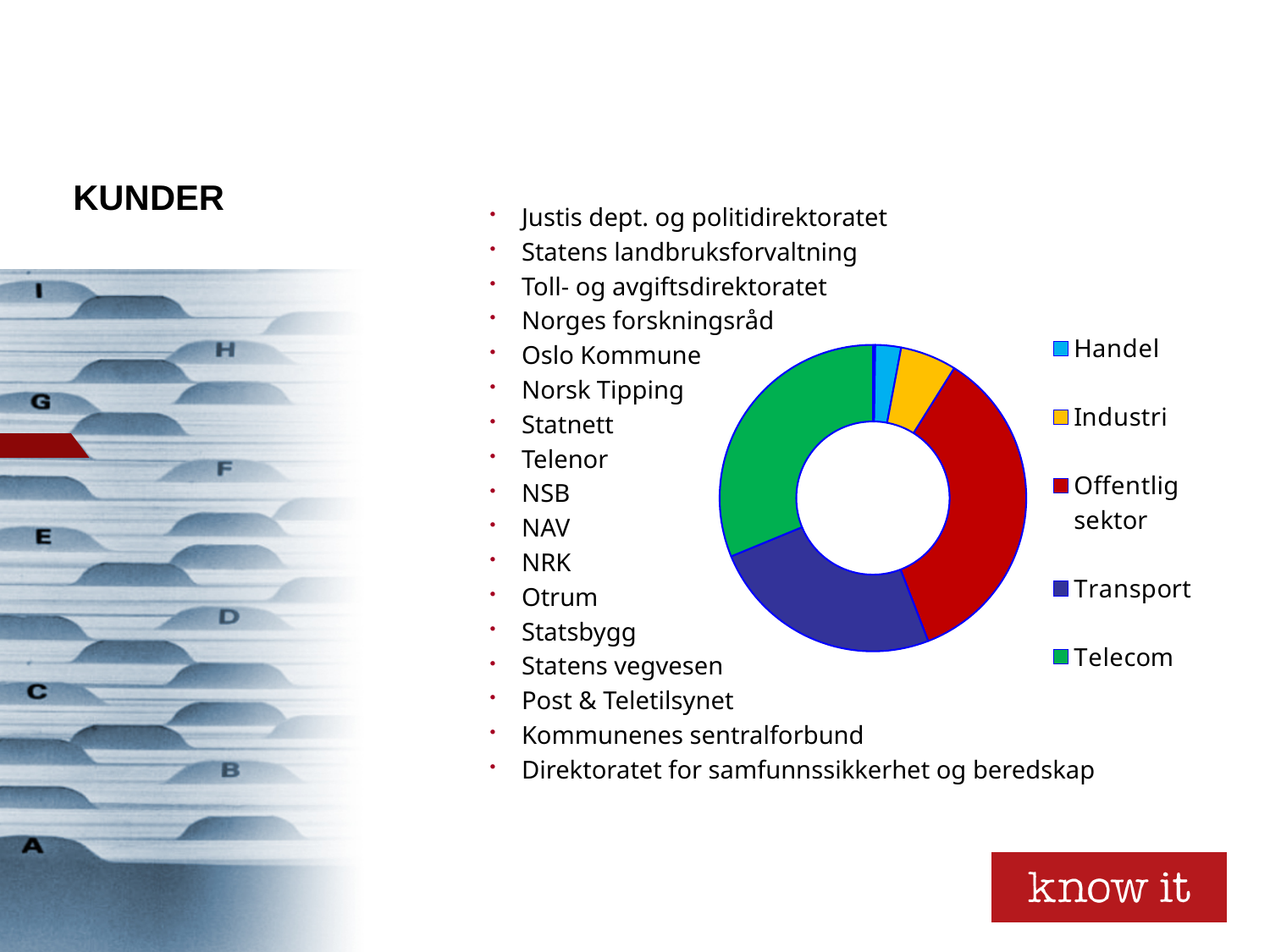
Which slice is larger in the doughnut chart, Handel or Industri? Industri Which slice is larger in the doughnut chart, Telecom or Industri? Telecom Which slice is larger in the doughnut chart, Offentlig sektor or Industri? Offentlig sektor Which colour represents Offentlig sektor in the doughnut chart? Red Which category has the smallest slice in the doughnut chart? Handel How many categories does the legend of the doughnut chart list? 5 What kind of chart is shown on the slide? Doughnut chart Which category is shown in green in the doughnut chart? Telecom